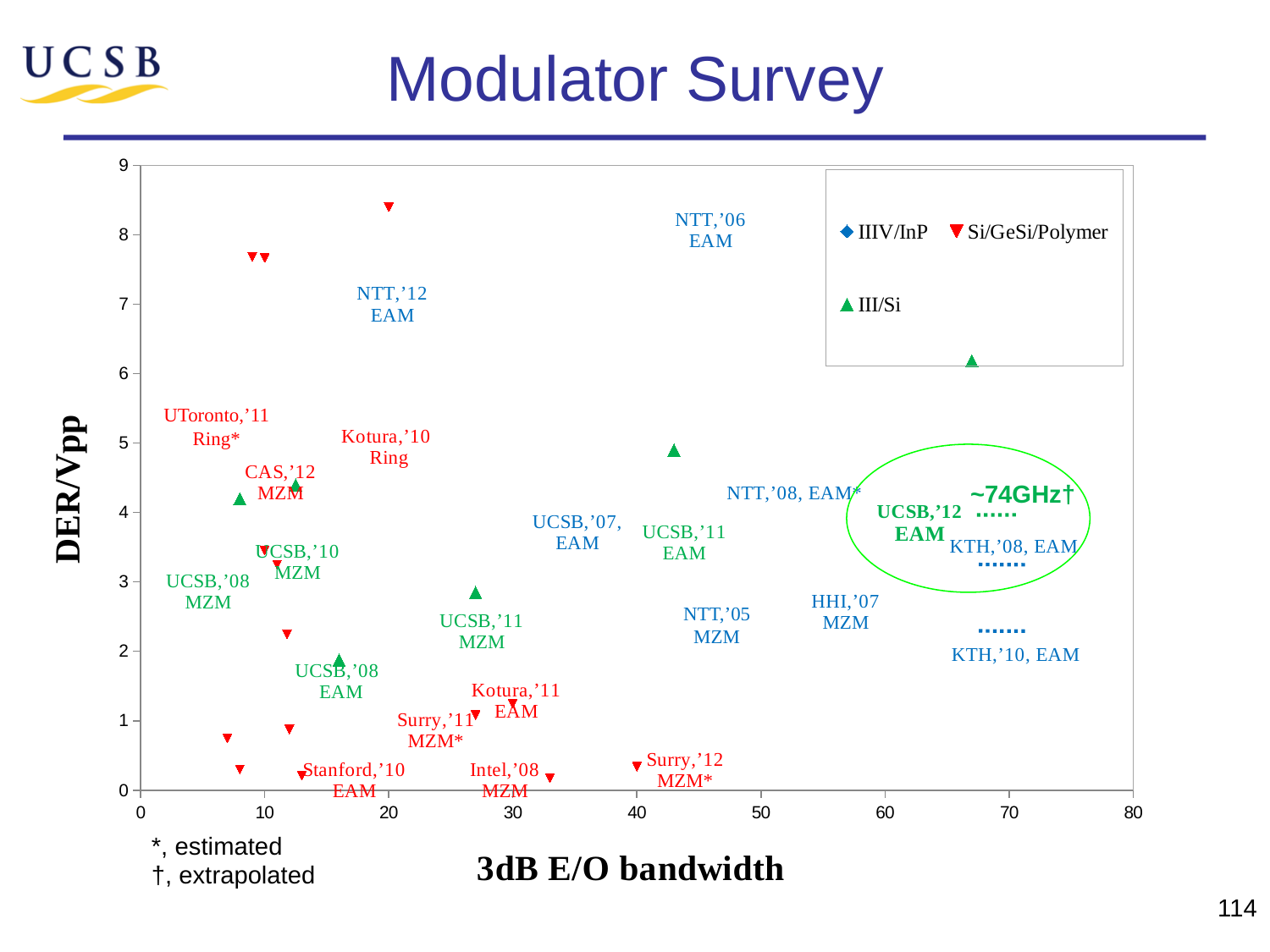
Is the DER/Vpp of the lowest plotted marker greater or less than 1? less Is the 3dB E/O bandwidth of the rightmost plotted marker greater or less than 70? less What is the title of the x axis? 3dB E/O bandwidth Is the DER/Vpp of the highest plotted marker greater or less than 8? greater What kind of chart is shown on the slide? scatter chart What are the three series named in the legend? IIIV/InP, Si/GeSi/Polymer, III/Si How many series does the legend list? 3